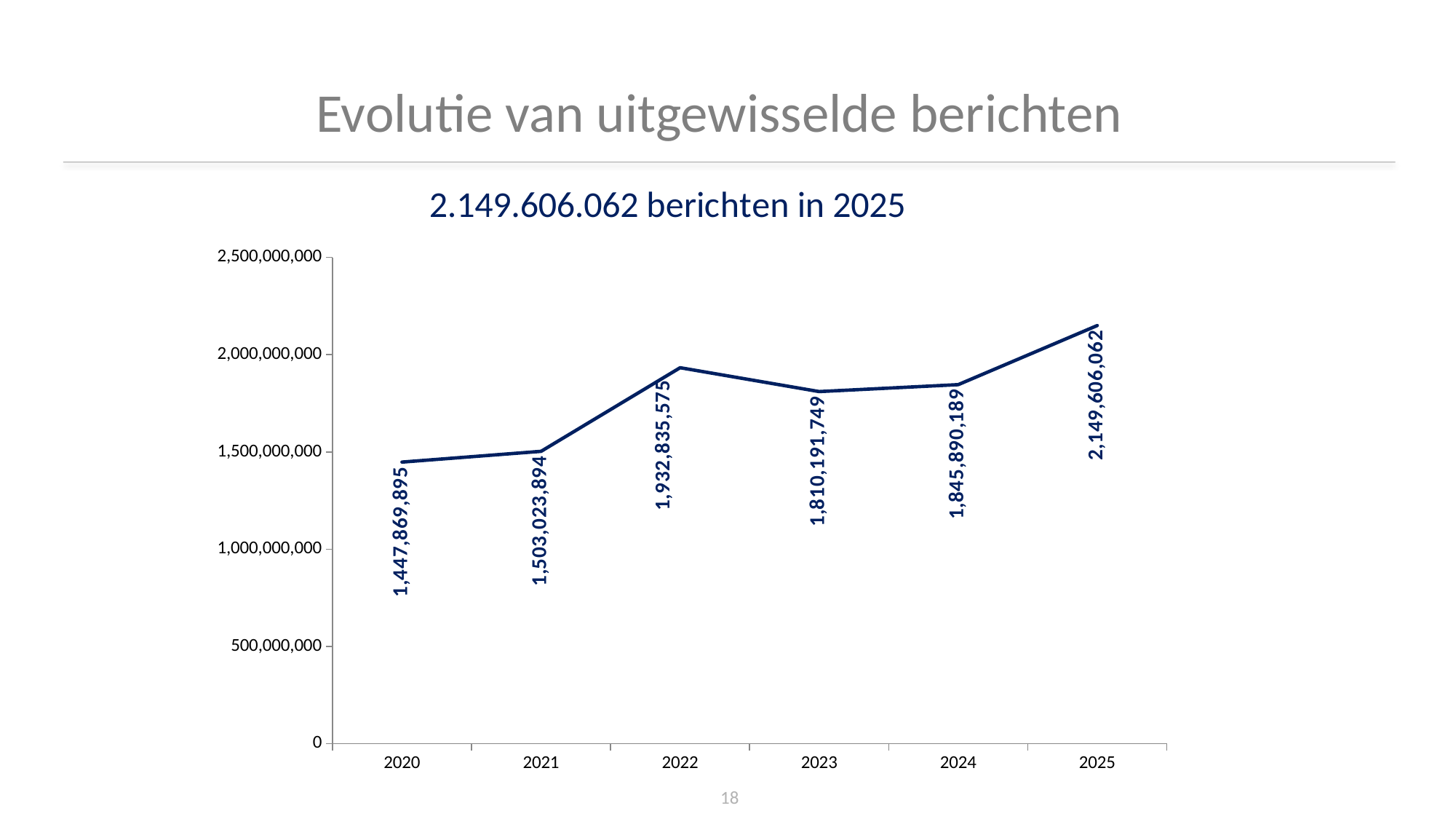
Which year has the lowest value? 2020 What is the value for 2024? 1,845,890,189 Is the value for 2025 greater or less than 2,000,000,000? greater What is the difference between the values for 2025 and 2024? 303,715,873 What is the difference between the values for 2022 and 2023? 122,643,826 What is the value for 2022? 1,932,835,575 Which is larger, the value for 2022 or the value for 2023? 2022 Which year has the highest value? 2025 How many years are plotted on the chart? 6 What kind of chart is shown on the slide? line chart What is the value for 2020? 1,447,869,895 What is the title of the chart? 2.149.606.062 berichten in 2025